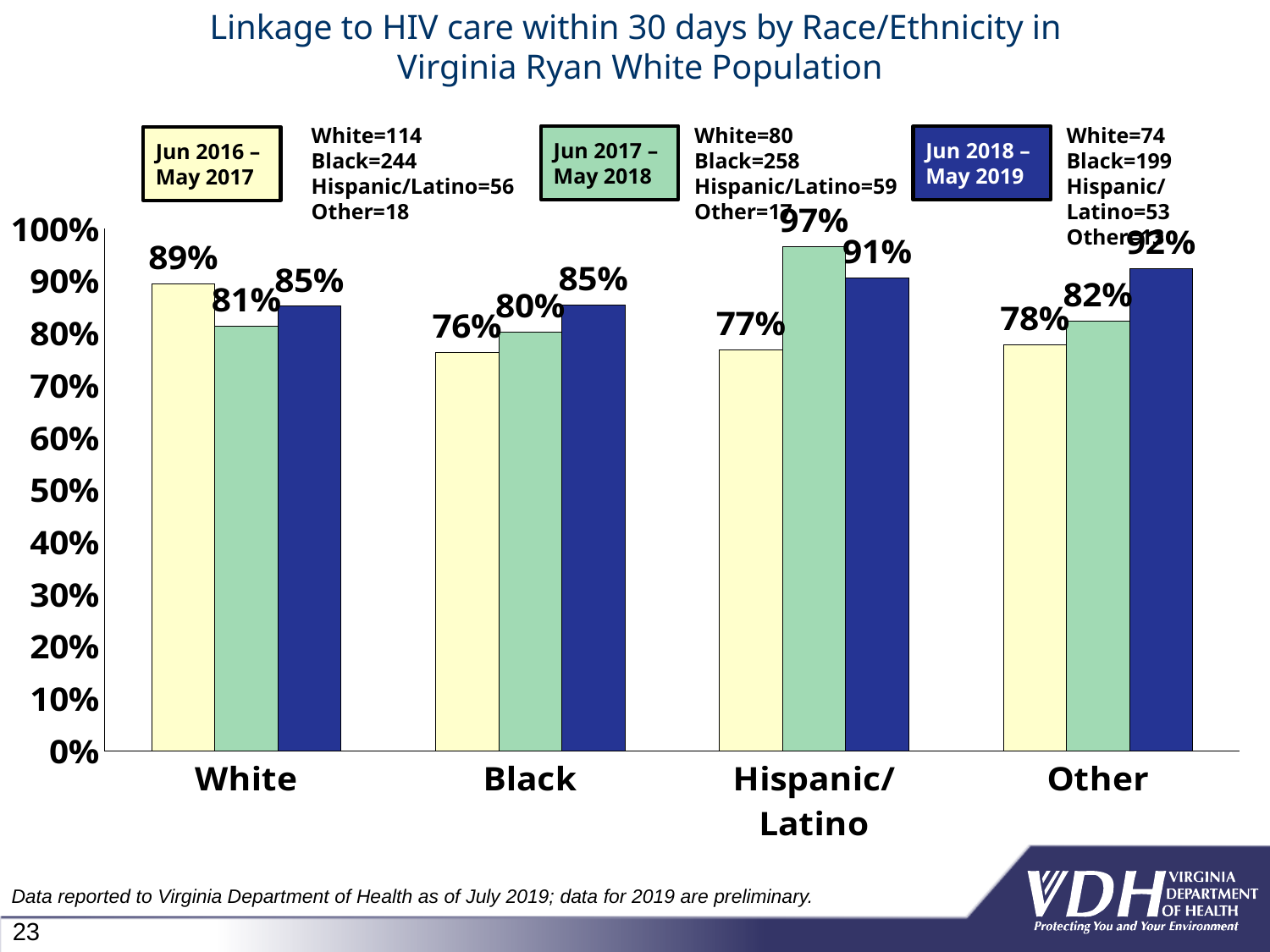
Which race/ethnicity group has the highest value in Jun 2017 – May 2018? Hispanic/Latino What is the value for Other in Jun 2016 – May 2017? 78% What is the linkage to HIV care value for White in Jun 2016 – May 2017? 89% Do the values for Black rise or fall from Jun 2016 – May 2017 to Jun 2018 – May 2019? rise Which is larger for White: the Jun 2016 – May 2017 value or the Jun 2018 – May 2019 value? Jun 2016 – May 2017 Which race/ethnicity group has the lowest value in Jun 2016 – May 2017? Black What is the value for Hispanic/Latino in Jun 2017 – May 2018? 97% How many race/ethnicity categories are shown on the x axis? 4 How many time periods (series) are shown in the legend? 3 What is the value for Black in Jun 2018 – May 2019? 85% What type of chart is shown on the slide? bar chart What is the difference between the Jun 2017 – May 2018 and Jun 2016 – May 2017 values for Hispanic/Latino? 20%